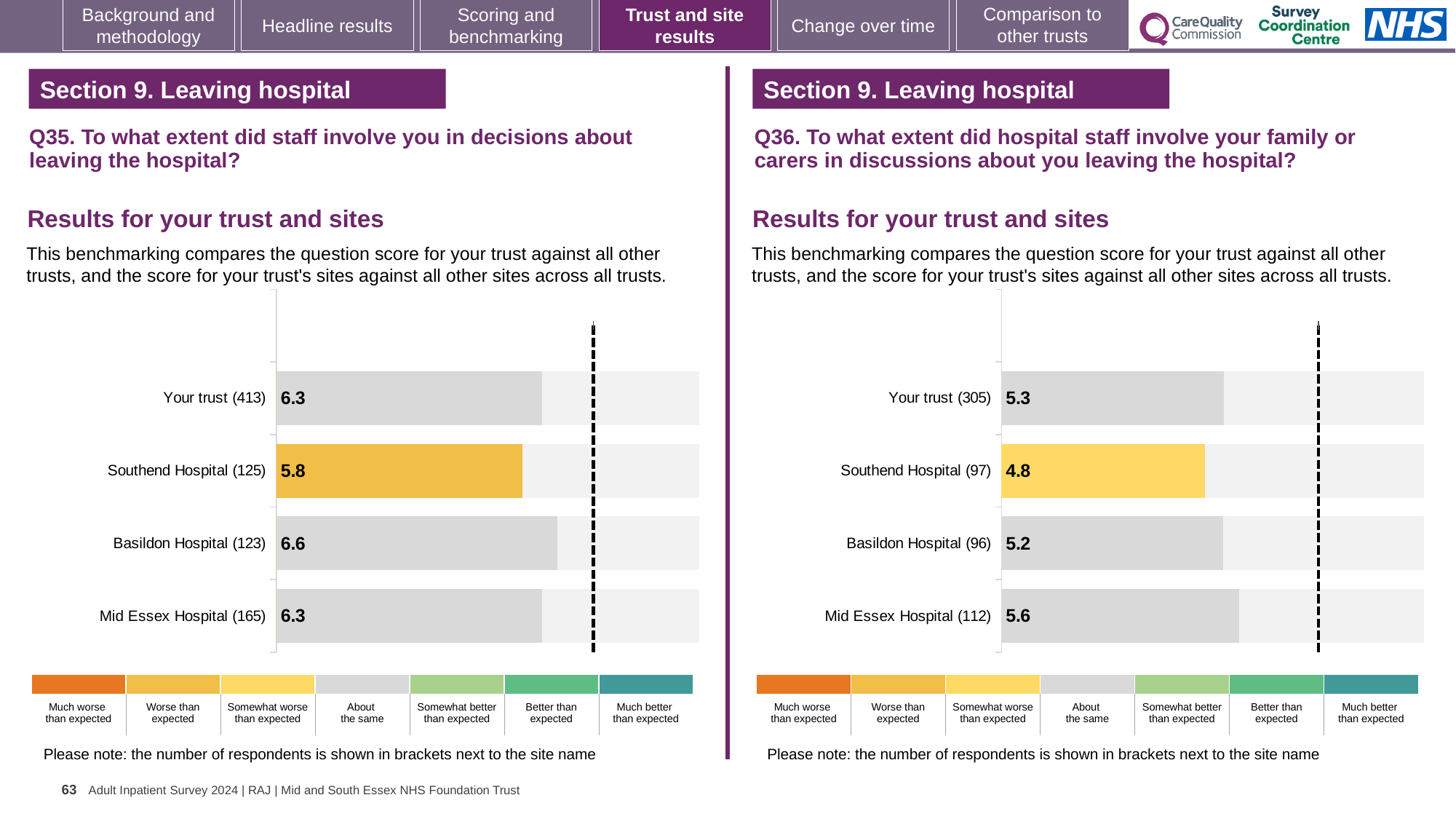
In the Q35 chart (left), which site has the highest score? Basildon Hospital In the Q35 chart (left), what is the score for Southend Hospital? 5.8 In the Q35 chart (left), what is the difference between the scores for Basildon Hospital and Southend Hospital? 0.8 In the Q35 chart (left), which site has the lowest score? Southend Hospital What type of chart is used for the Q36 results (right)? Bar chart In the Q36 chart (right), what is the difference between the scores for Your trust and Southend Hospital? 0.5 In the Q36 chart (right), which is larger, the score for Your trust or the score for Basildon Hospital? Your trust How many bars are plotted in the Q35 chart (left)? 4 In the Q36 chart (right), what is the score for Basildon Hospital? 5.2 In the Q36 chart (right), what is the score for Mid Essex Hospital? 5.6 In the Q35 chart (left), what is the score for Your trust? 6.3 In the Q36 chart (right), which site has the lowest score? Southend Hospital